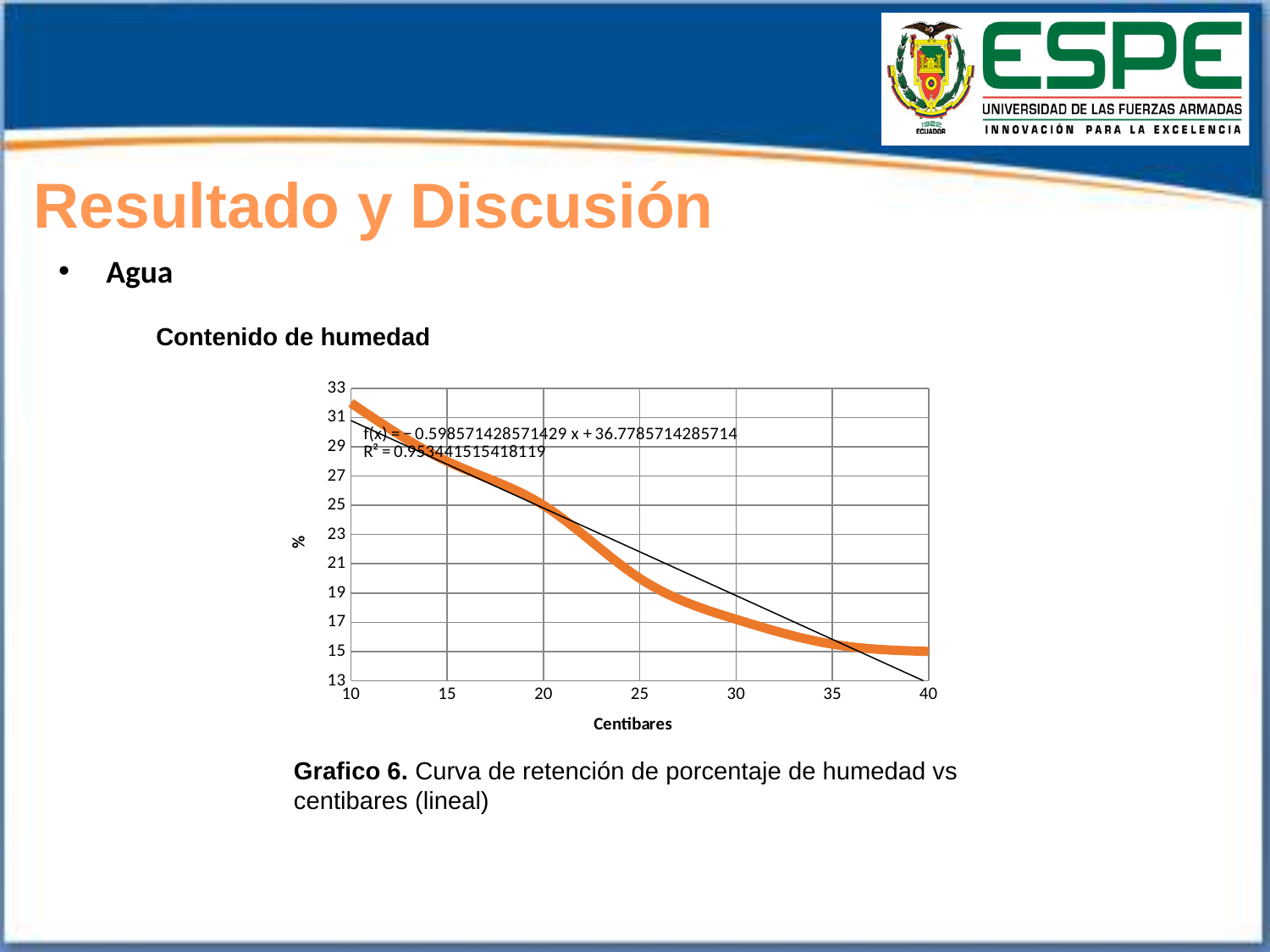
Which has the lower plotted value, 20 centibares or 30 centibares? 30 centibares Is the value for 25 centibares greater or less than 21? less Is the value for 15 centibares greater or less than 25? greater What is the label of the x axis of the chart? Centibares Is the value for 30 centibares greater or less than 19? less Do the plotted humidity values rise or fall as centibares increase from 10 to 40? fall What kind of chart is shown on the slide? line chart Which has the higher plotted value, 10 centibares or 40 centibares? 10 centibares What is the R² value shown for the trendline on the chart? 0.953441515418119